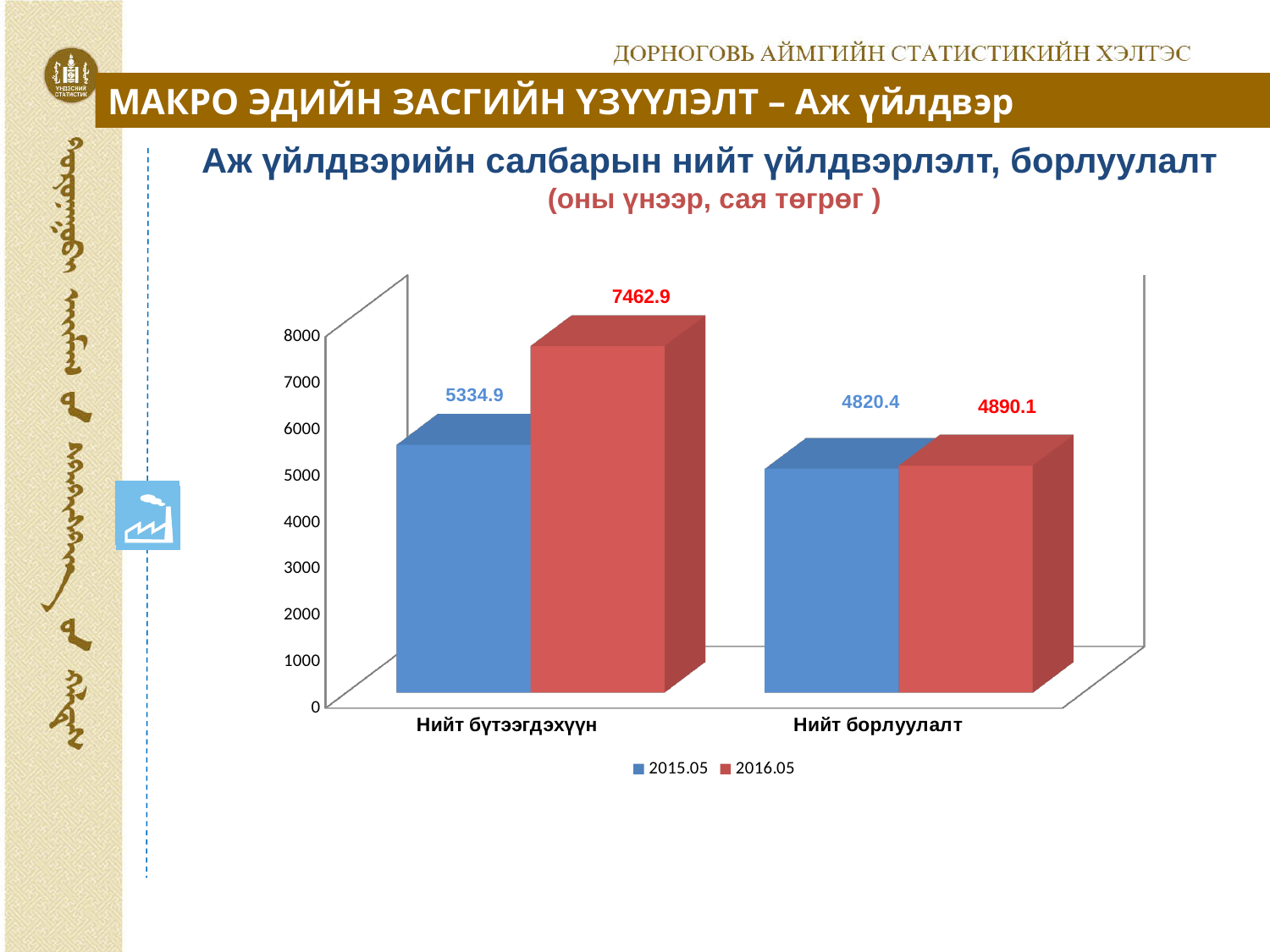
What is the value for 2015.05 in the Нийт бүтээгдэхүүн category? 5334.9 Which bar has the highest value on the chart? 2016.05, Нийт бүтээгдэхүүн How many series does the legend list? 2 What kind of chart is shown on the slide? Bar chart What is the value for 2016.05 in the Нийт бүтээгдэхүүн category? 7462.9 For Нийт борлуулалт, which series has the larger value, 2015.05 or 2016.05? 2016.05 What is the difference between the 2016.05 and 2015.05 values for Нийт борлуулалт? 69.7 How many categories are shown on the x axis? 2 What is the difference between the 2016.05 and 2015.05 values for Нийт бүтээгдэхүүн? 2128.0 Which bar has the lowest value on the chart? 2015.05, Нийт борлуулалт What is the value for 2016.05 in the Нийт борлуулалт category? 4890.1 What is the value for 2015.05 in the Нийт борлуулалт category? 4820.4